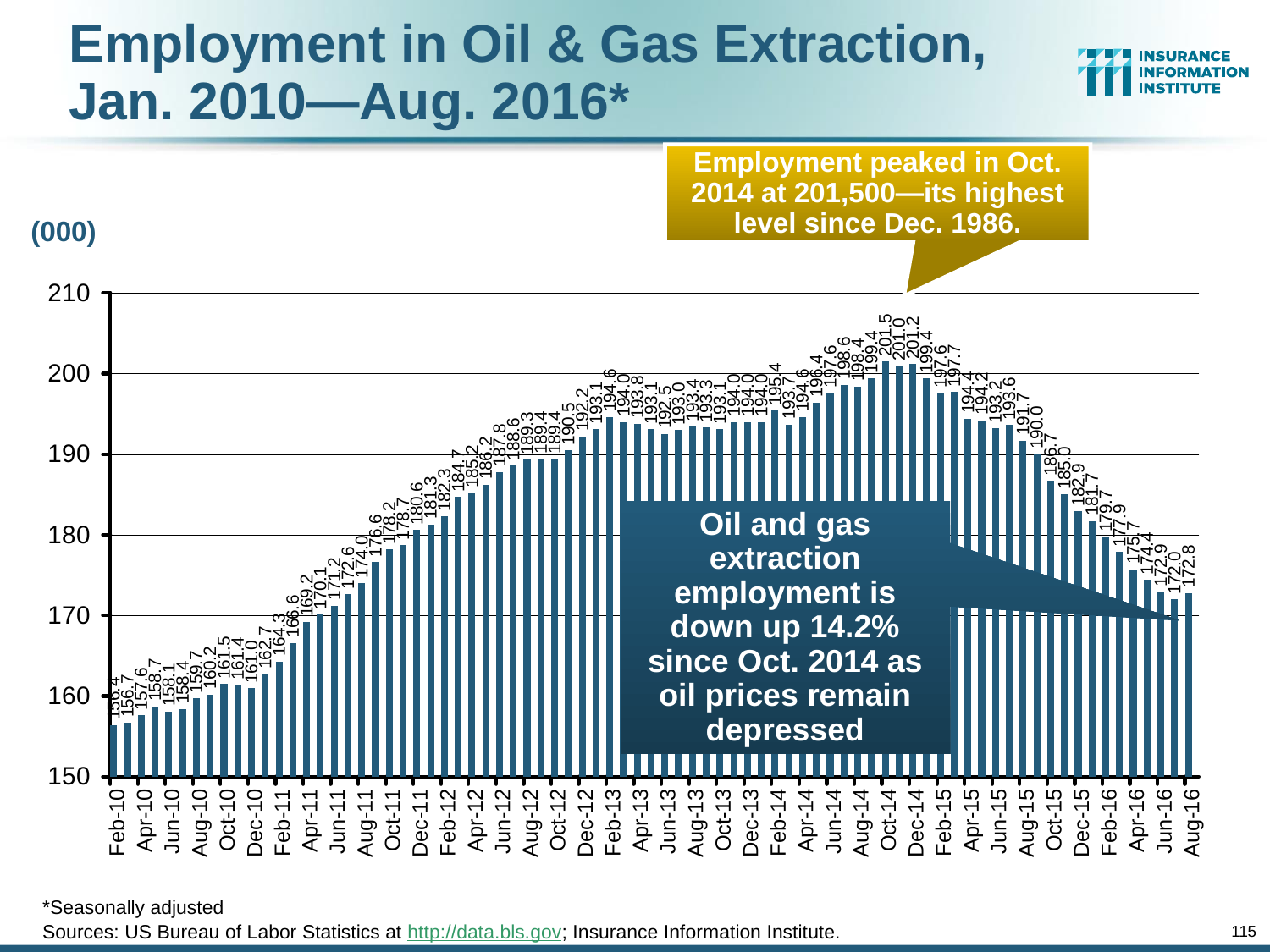
Do the values generally rise or fall from Feb-10 to Oct-14? rise In what units are the values on the vertical axis expressed, according to the label above the axis? (000) Is the value for Feb-13 greater or less than 190? greater What is the value for Aug-16, the last bar on the chart? 172.8 Which is larger, the value for Oct-14 or the value for Aug-16? Oct-14 Do the values generally rise or fall from Oct-14 to Aug-16? fall What is the highest employment value shown on the chart, and in which month does it occur? 201.5 in Oct-14 What is the lowest value labeled on the chart? 156.4 Is the value for Feb-11 greater or less than 170? less Is the value for Dec-15 greater or less than 190? less What type of chart is shown on the slide? bar chart What is the difference between the Oct-14 peak value and the Aug-16 value? 28.7